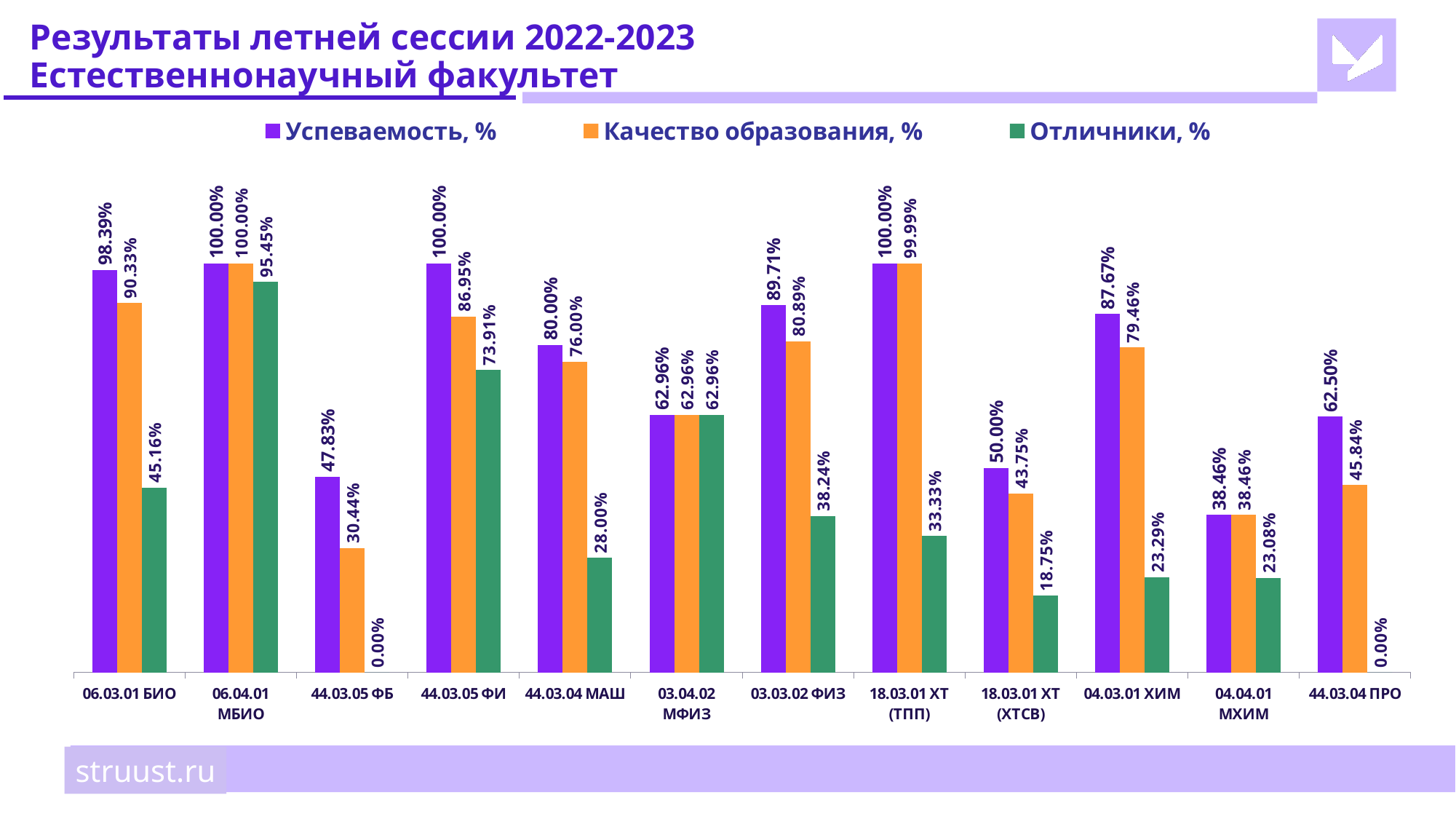
Which category has the lowest value of Успеваемость, %? 04.04.01 МХИМ What is the value of Качество образования, % for 44.03.05 ФИ? 86.95% Which category has the lowest value of Качество образования, %? 44.03.05 ФБ What is the difference between Успеваемость, % and Качество образования, % for 04.03.01 ХИМ? 8.21% What is the value of Отличники, % for 18.03.01 ХТ (ТПП)? 33.33% Which category has the highest value of Отличники, %? 06.04.01 МБИО How many series does the legend list? 3 What is the value of Качество образования, % for 44.03.04 ПРО? 45.84% What kind of chart is shown on the slide? Bar chart How many categories are shown on the x axis? 12 Which is larger for 44.03.04 МАШ: Успеваемость, % or Отличники, %? Успеваемость, % What is the value of Успеваемость, % for 06.03.01 БИО? 98.39%